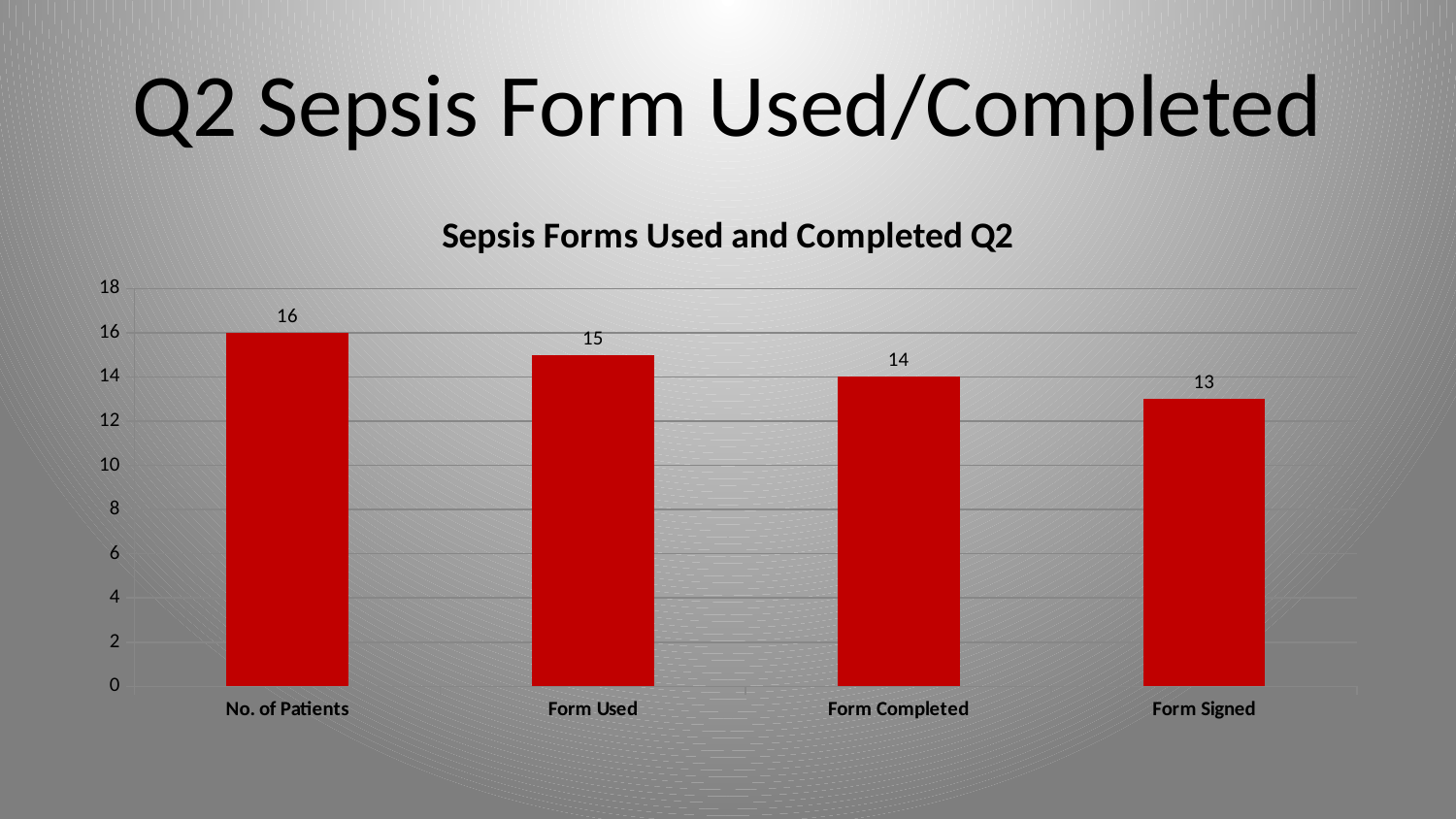
What is the difference between No. of Patients and Form Signed? 3 What is the value for Form Signed? 13 What is the value for No. of Patients? 16 Which category has the lowest value? Form Signed Is the value for Form Signed greater or less than 14? less What is the value for Form Used? 15 How many categories are shown on the x axis? 4 Which is larger, Form Used or Form Completed? Form Used Which category has the highest value? No. of Patients What kind of chart is shown? Bar chart What is the value for Form Completed? 14 Do the values rise or fall from left to right along the x axis? Fall